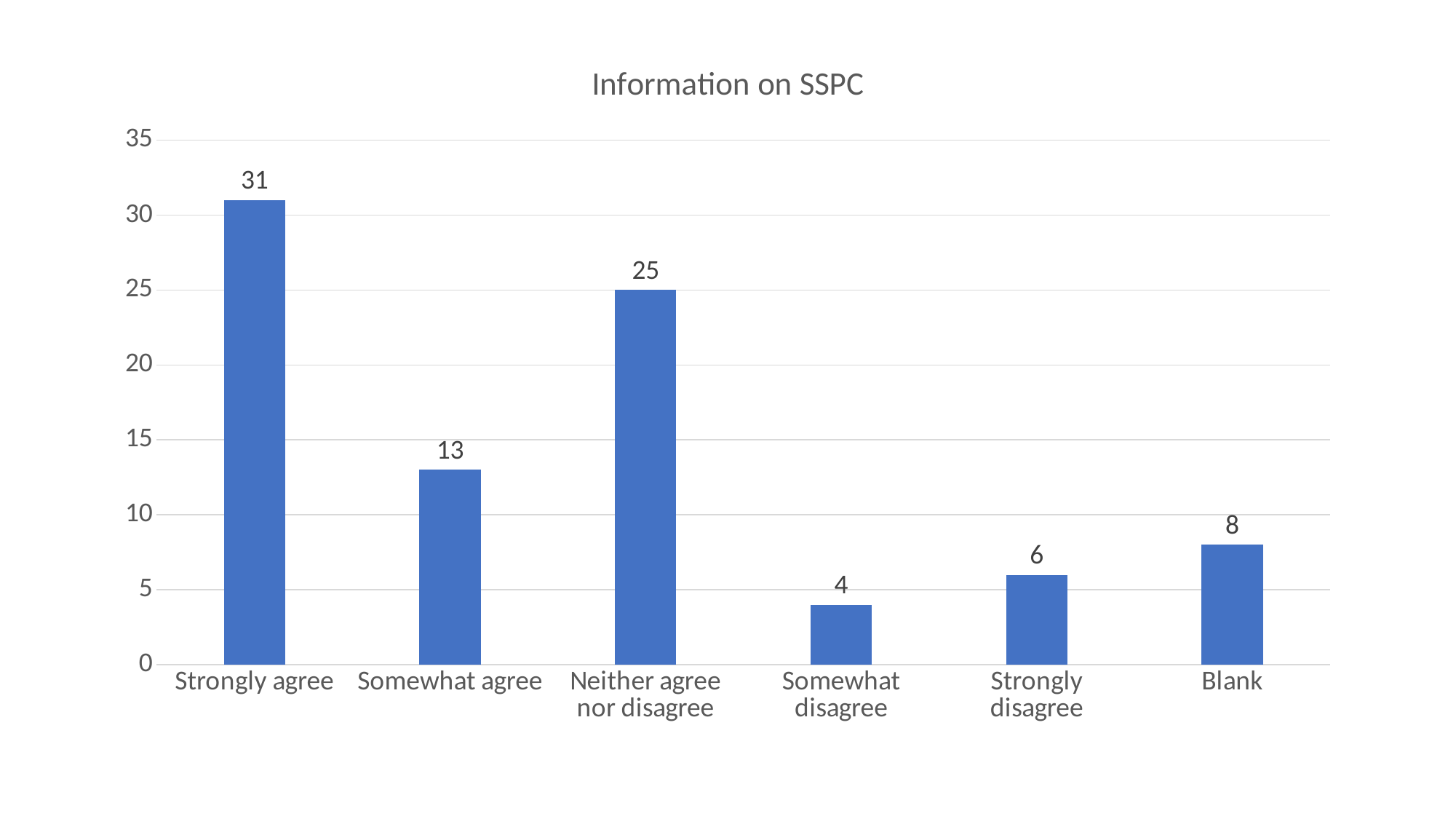
What kind of chart is shown on the slide? bar chart What is the value for Strongly agree? 31 What is the difference between the values for Blank and Strongly disagree? 2 Which category has the lowest value? Somewhat disagree What is the value for Neither agree nor disagree? 25 What is the value for Blank? 8 How many categories are shown on the x axis? 6 Which category has the highest value? Strongly agree Which is larger, the value for Somewhat agree or the value for Neither agree nor disagree? Neither agree nor disagree Is the value for Somewhat agree greater or less than 10? greater What is the difference between the values for Strongly agree and Somewhat agree? 18 What is the title of the chart? Information on SSPC